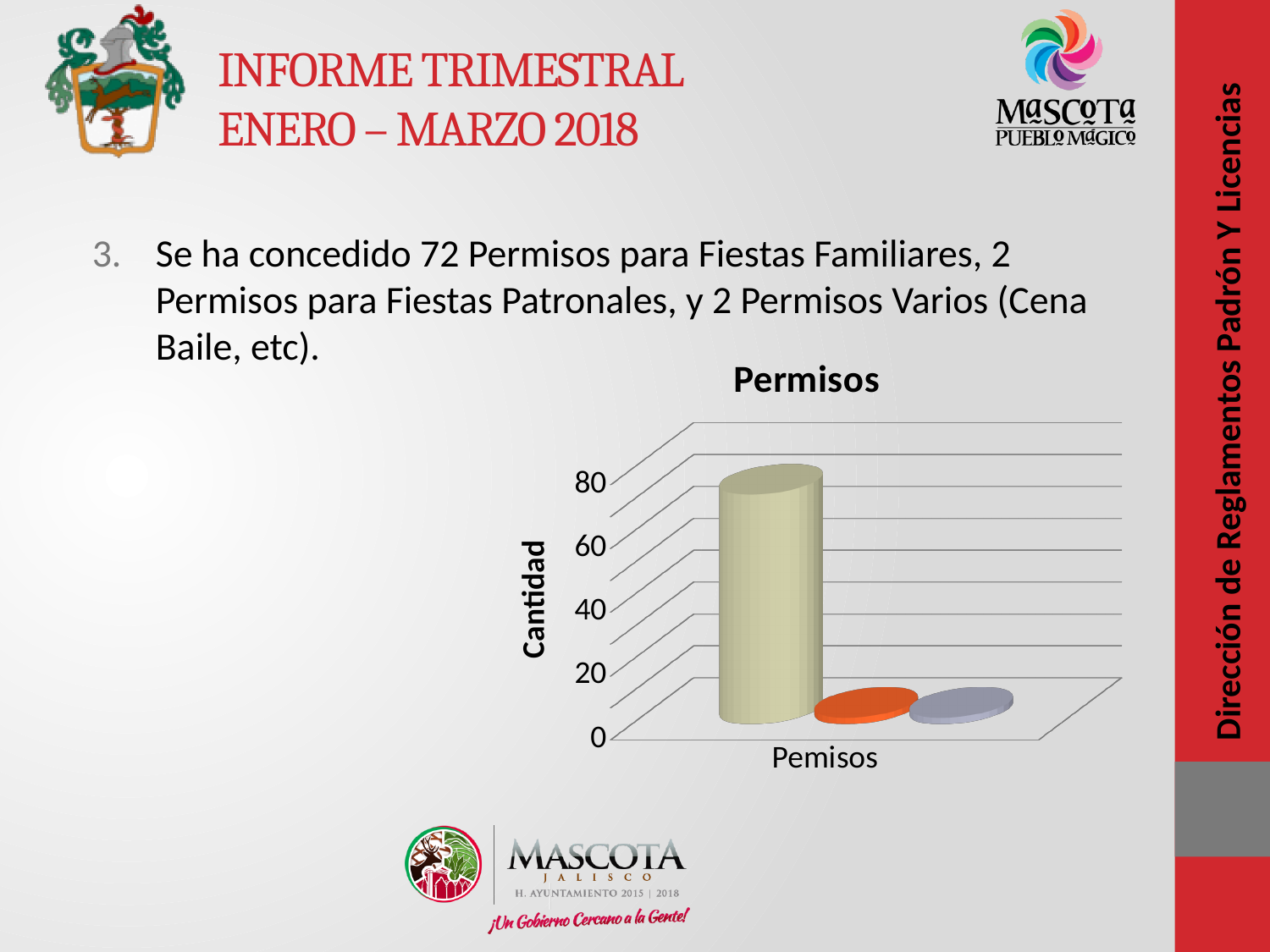
How many bars are plotted in the chart? 3 What is the label on the vertical axis of the chart? Cantidad Is the value of the grey bar greater or less than 20? less Is the value of the tallest (beige) bar greater or less than 60? greater What is the highest tick value shown on the vertical axis of the chart? 80 What kind of chart is shown on the slide? bar chart Which is larger, the beige bar or the orange bar? the beige bar What is the title of the chart? Permisos How many categories are shown on the horizontal axis of the chart? 1 Is the value of the orange bar greater or less than 20? less Which colour bar is the tallest in the chart? beige